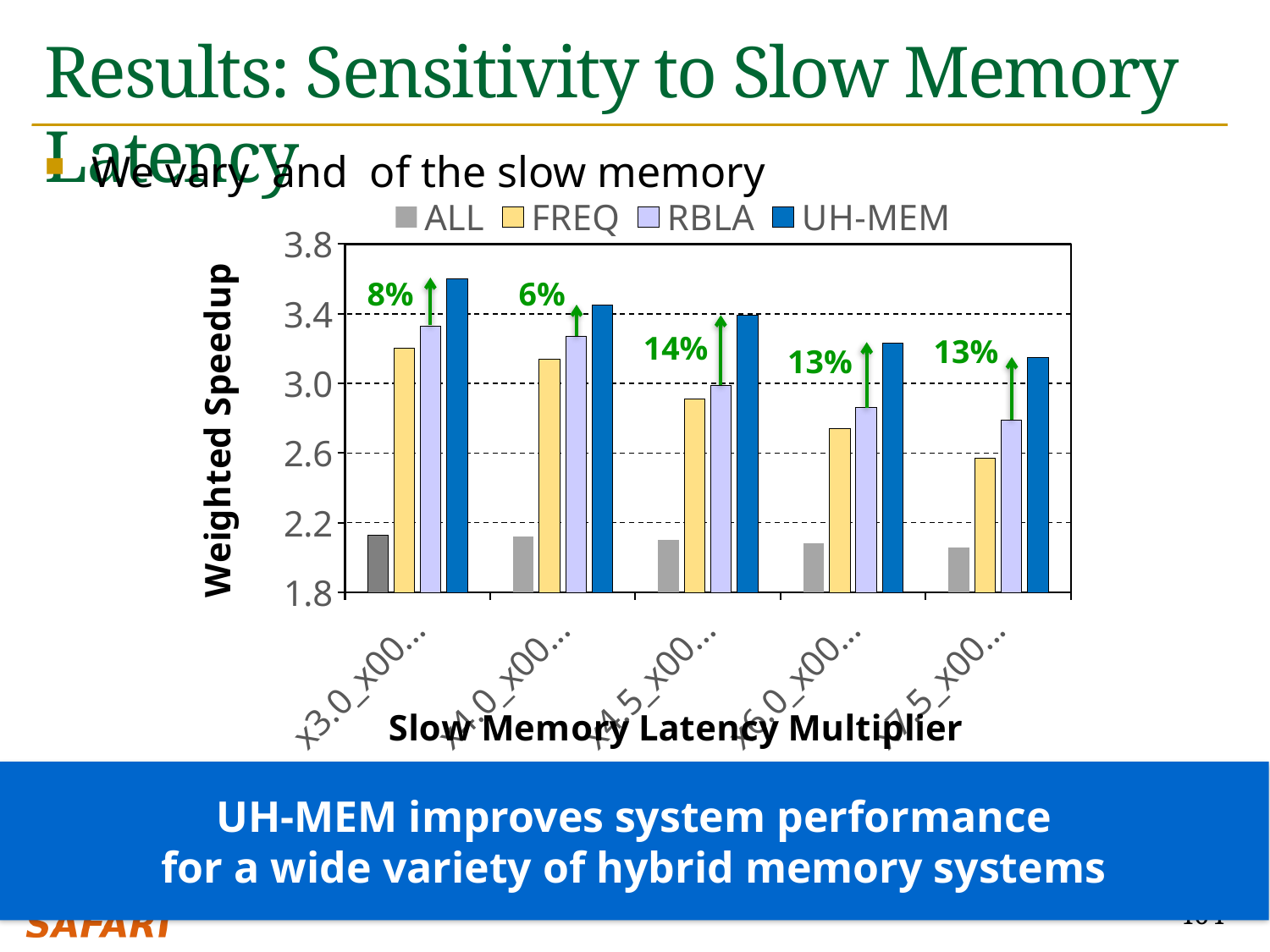
Do the UH-MEM values rise or fall as the slow memory latency multiplier increases along the x axis? fall In the x3.0 category, which is larger, the UH-MEM bar or the FREQ bar? UH-MEM How many series does the legend list? 4 What is the title of the y axis? Weighted Speedup What kind of chart is shown on the slide? bar chart Is the FREQ value for the x6.0 category greater or less than 2.6? greater How many slow memory latency multiplier categories are plotted along the x axis? 5 Is the ALL value for the first category (x3.0) greater or less than 2.2? less What percentage improvement is annotated above the x4.5 category group? 14% What is the title of the x axis? Slow Memory Latency Multiplier Is the UH-MEM value for the first category (x3.0) greater or less than 3.4? greater Which series has the lowest value in every category? ALL